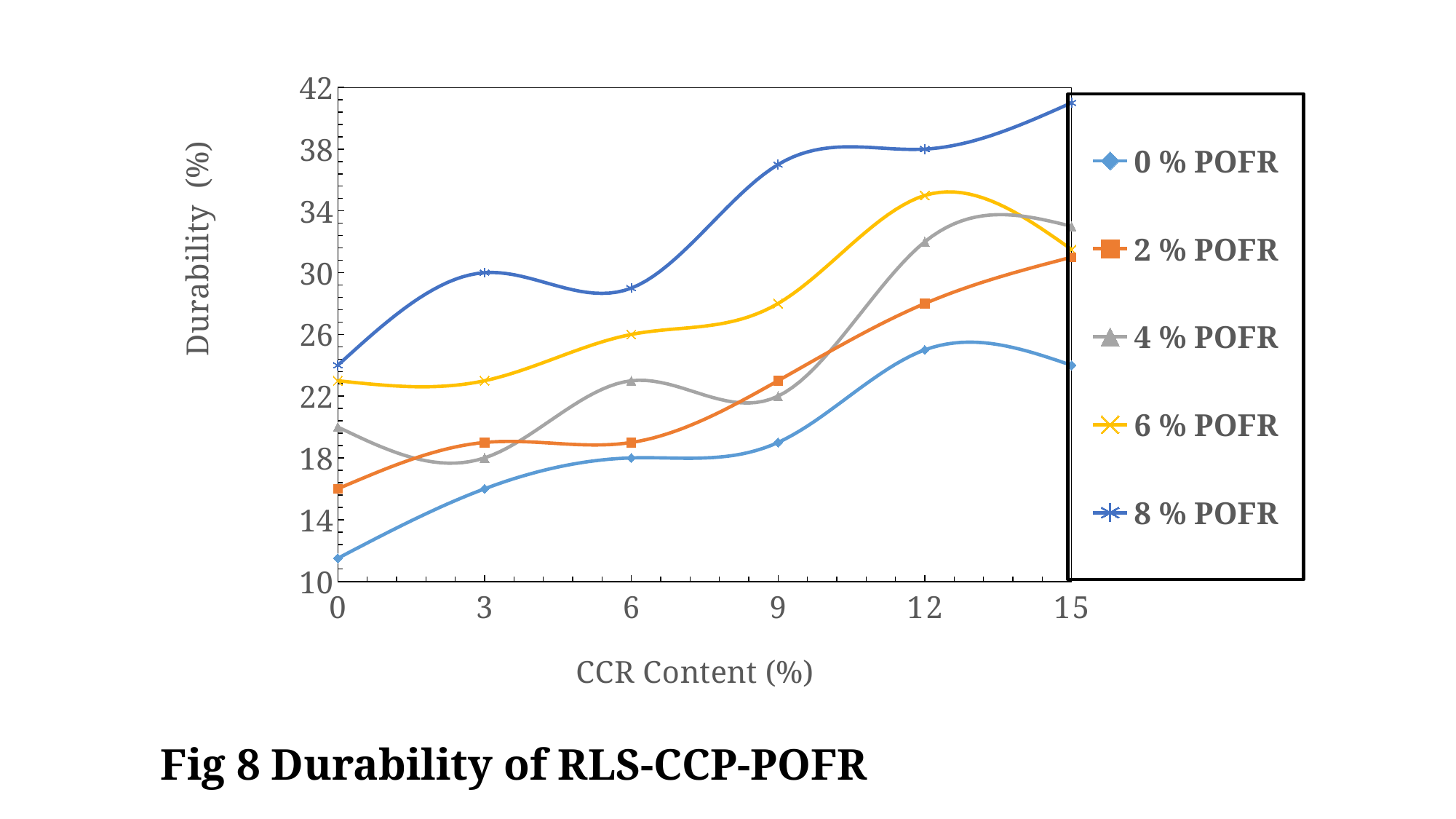
What is the durability for 6 % POFR at 6 % CCR content? 26 What is the durability for 8 % POFR at 12 % CCR content? 38 Which series has the lowest durability at 0 % CCR content? 0 % POFR Which is larger at 9 % CCR content: the durability for 2 % POFR or for 6 % POFR? 6 % POFR Is the durability for 0 % POFR at 0 % CCR content greater or less than 14? less What kind of chart is shown on the slide? line chart What is the durability for 0 % POFR at 6 % CCR content? 18 Which series has the highest durability at 15 % CCR content? 8 % POFR How many series does the legend list? 5 What is the durability for 8 % POFR at 3 % CCR content? 30 What is the label of the y axis? Durability (%) How many CCR content levels are plotted along the x axis? 6